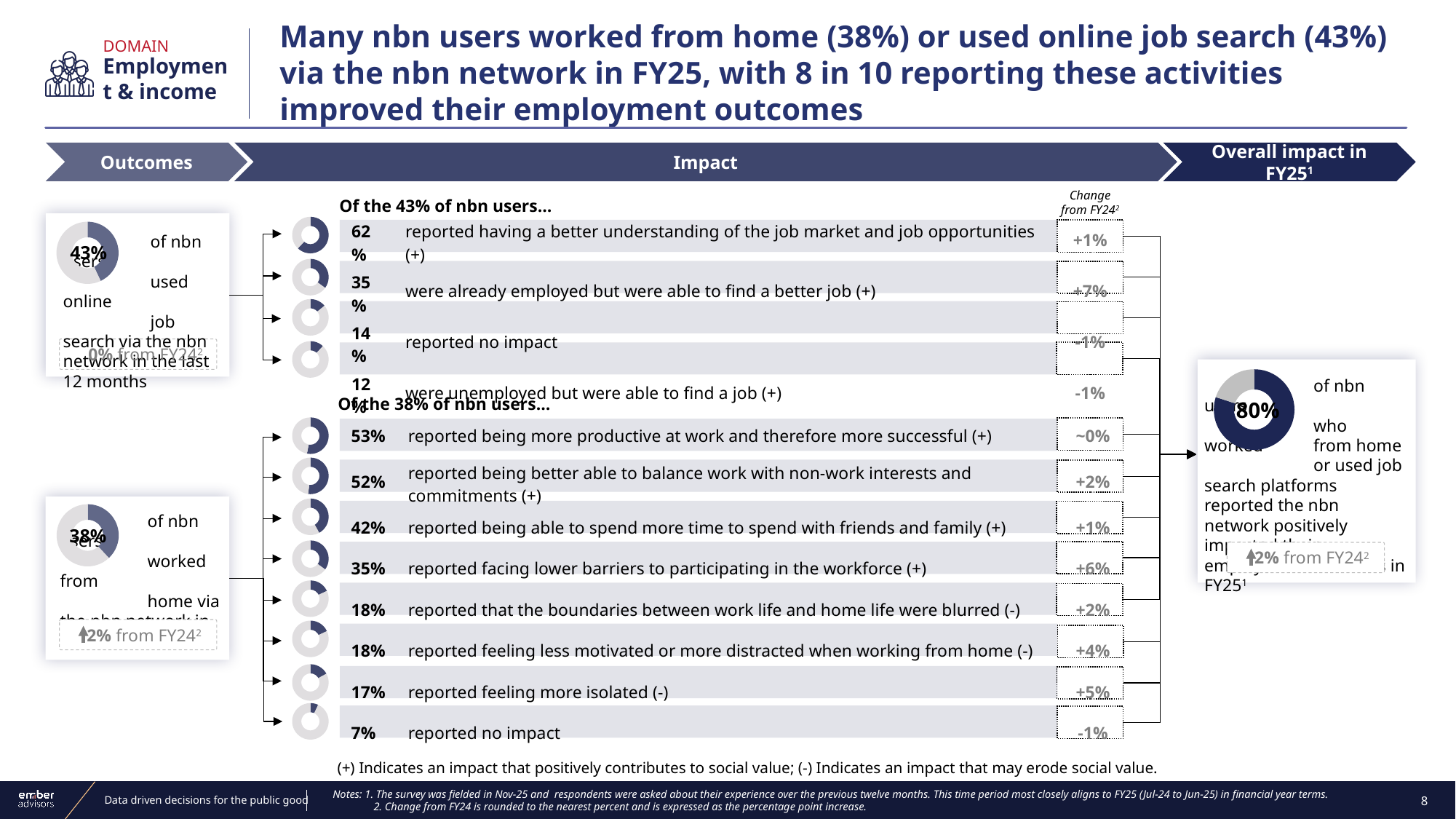
Which is larger: the share of online job search users who were already employed but found a better job, or the share who were unemployed but were able to find a job? were already employed but were able to find a better job (35%) What percentage of nbn users worked from home via the nbn network, according to the lower donut chart in the Outcomes column? 38% What is the difference between the share of work-from-home users who reported being more productive (53%) and the share who reported feeling more isolated (17%)? 36 percentage points Of the 43% of nbn users who used online job search, what percentage reported having a better understanding of the job market and job opportunities? 62% How many impact rows with donut charts are listed for the 38% of nbn users who worked from home? 8 What type of chart is used to show the 80% overall impact figure? Donut (pie) chart In the Overall impact in FY25 donut chart, what share of nbn users who worked from home or used job search platforms reported the nbn network positively impacted their employment? 80% Of the 38% of nbn users who worked from home, what percentage reported being more productive at work? 53% What is the change from FY24 for the share of online job search users who were already employed but were able to find a better job? +7% What percentage of nbn users used online job search via the nbn network in the last 12 months, according to the donut chart in the Outcomes column? 43% Among the impacts listed for the 43% of nbn users who used online job search, which impact has the highest percentage? reported having a better understanding of the job market and job opportunities (62%) Among the impacts listed for the 38% of nbn users who worked from home, which impact has the lowest percentage? reported no impact (7%)